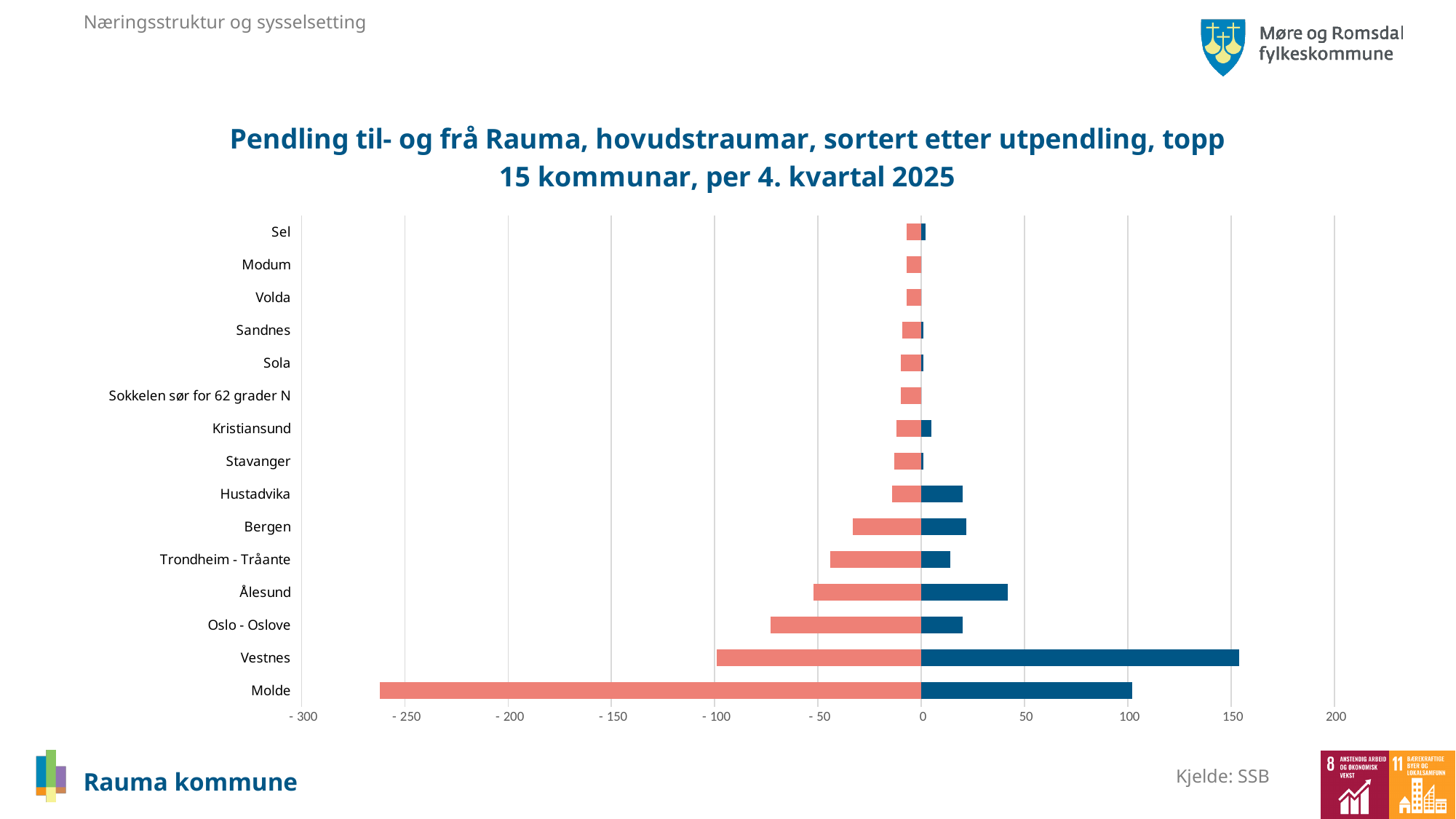
Is the red bar value for Oslo - Oslove greater or less than -50? less Is the blue bar value for Hustadvika greater or less than 50? less Which municipality has the longest red (negative) bar in the chart? Molde Is the blue bar value for Ålesund greater or less than 50? less Which has the larger blue bar, Ålesund or Oslo - Oslove? Ålesund How many municipalities (categories) are listed on the vertical axis of the chart? 15 Which municipality has the longest blue (positive) bar in the chart? Vestnes What is the title of the chart? Pendling til- og frå Rauma, hovudstraumar, sortert etter utpendling, topp 15 kommunar, per 4. kvartal 2025 Which has the longer red bar, Trondheim - Tråante or Bergen? Trondheim - Tråante What kind of chart is shown on the slide? bar chart